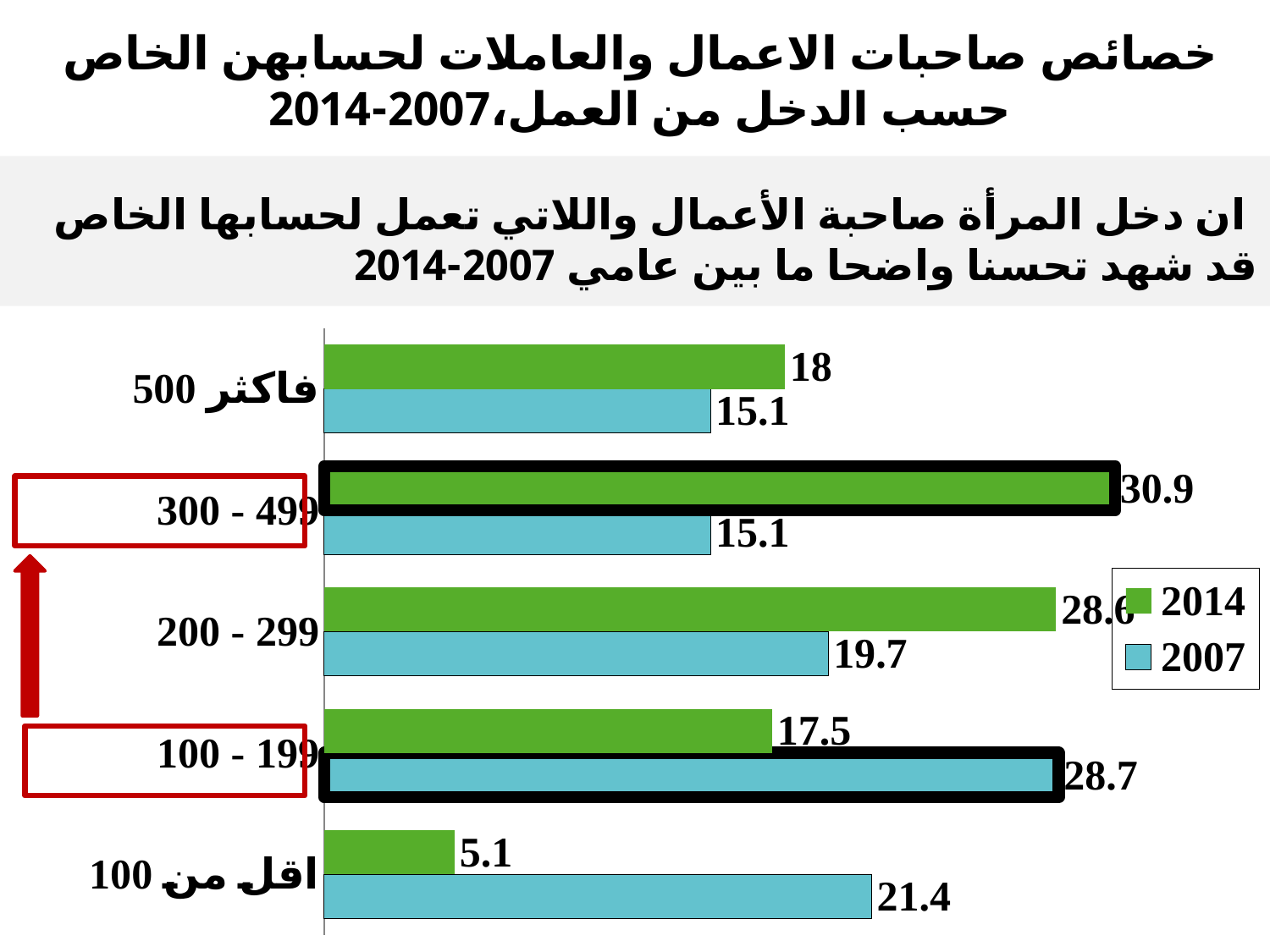
What is the 2014 value for the 300 - 499 category? 30.9 Which category has the lowest 2014 value? اقل من 100 Which category has the highest 2007 value? 100 - 199 What is the difference between the 2014 and 2007 values for the 300 - 499 category? 15.8 What is the 2007 value for the '500 فاكثر' category? 15.1 Which category has the highest 2014 value? 300 - 499 How many series does the legend list? 2 What type of chart is shown on the slide? bar chart How many income categories are shown on the chart? 5 What is the 2014 value for the 'اقل من 100' category? 5.1 For the 'اقل من 100' category, which series has the larger value, 2014 or 2007? 2007 What is the 2007 value for the 100 - 199 category? 28.7